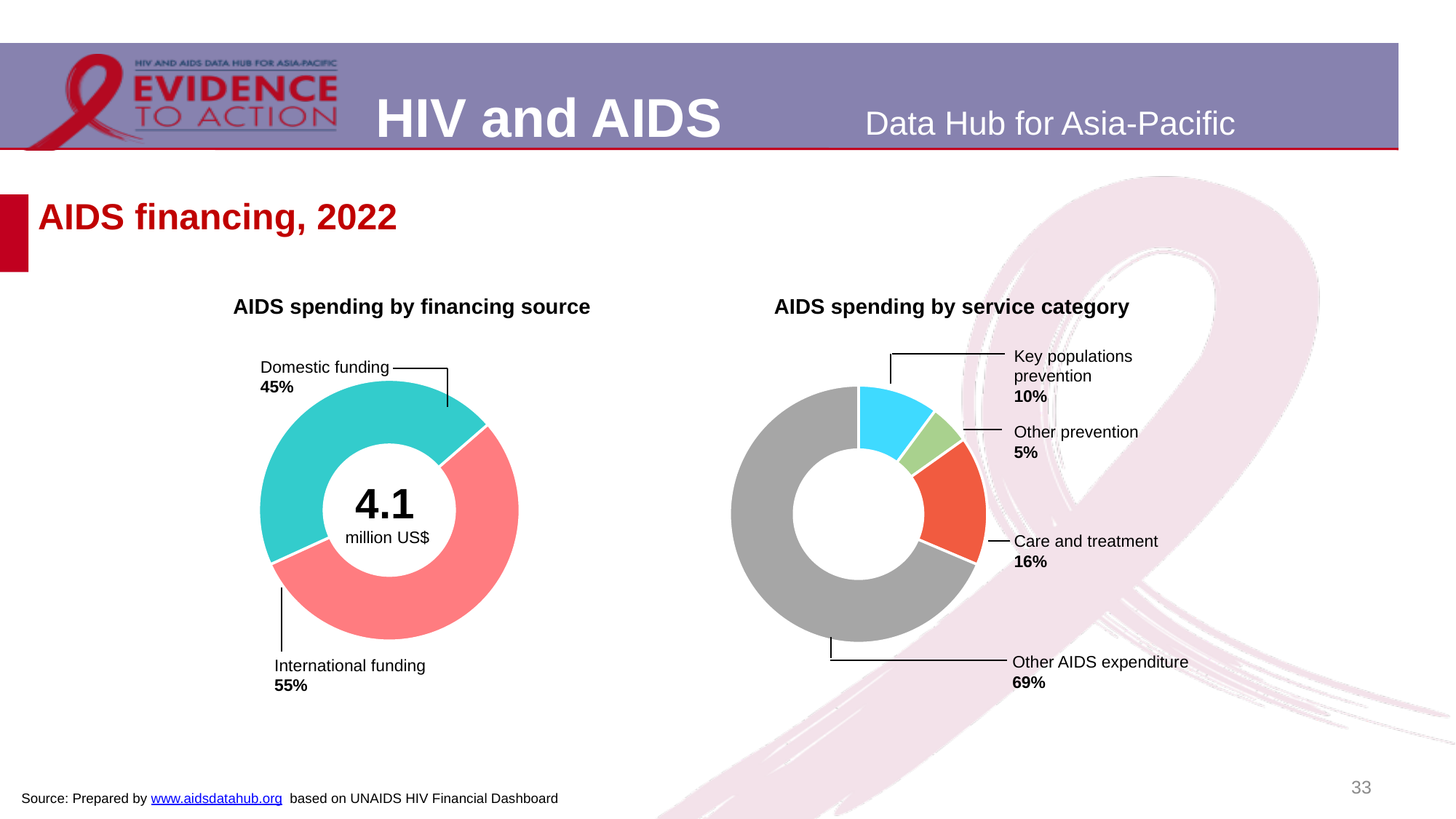
In the 'AIDS spending by financing source' chart, what share is International funding? 55% In the 'AIDS spending by financing source' chart, what is the difference in percentage points between International funding and Domestic funding? 10 percentage points In the 'AIDS spending by service category' chart, which category has the largest share? Other AIDS expenditure In the 'AIDS spending by financing source' chart, what total amount is shown in the centre of the donut? 4.1 million US$ In the 'AIDS spending by service category' chart, how many service categories are shown? 4 What type of chart is used for 'AIDS spending by financing source'? Donut (pie) chart In the 'AIDS spending by service category' chart, is the share for Care and treatment larger or smaller than the share for Key populations prevention? larger In the 'AIDS spending by financing source' chart, which financing source has the larger share? International funding In the 'AIDS spending by service category' chart, which category has the smallest share? Other prevention In the 'AIDS spending by financing source' chart, what share is Domestic funding? 45% In the 'AIDS spending by service category' chart, what share is Care and treatment? 16% In the 'AIDS spending by service category' chart, what share is Key populations prevention? 10%